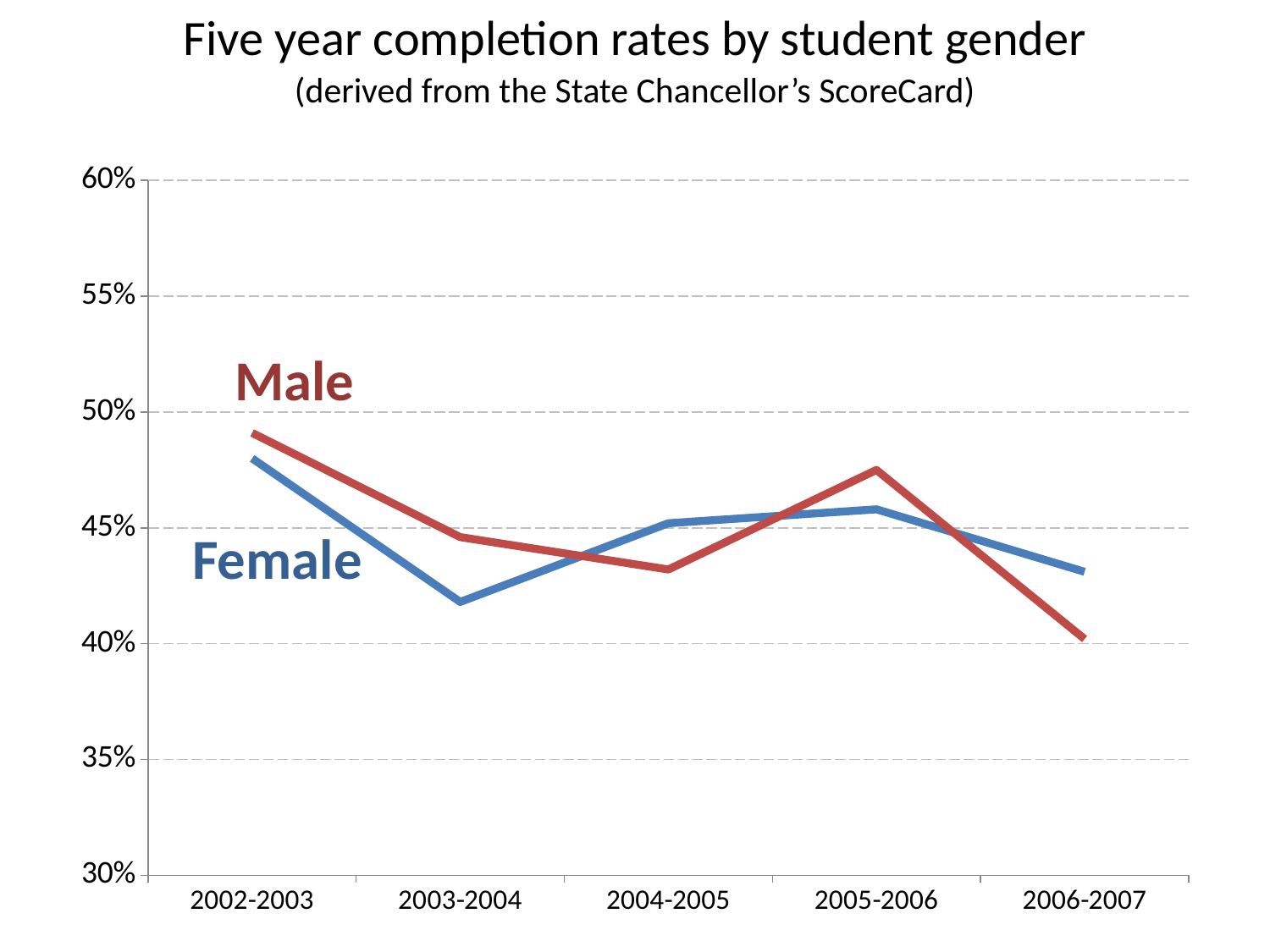
In which year is the Male completion rate lowest? 2006-2007 Is the Female completion rate for 2003-2004 greater or less than 45%? less Is the Male completion rate for 2002-2003 greater or less than 50%? less Does the Male completion rate rise or fall from 2005-2006 to 2006-2007? fall In 2006-2007, which series has the higher completion rate, Male or Female? Female In which year is the Male completion rate highest? 2002-2003 How many academic years are shown on the x axis? 5 In 2003-2004, which series has the higher completion rate, Male or Female? Male What kind of chart is shown on the slide? line chart Is the Male completion rate for 2005-2006 greater or less than 45%? greater In which year is the Female completion rate lowest? 2003-2004 How many series are plotted on the chart? 2